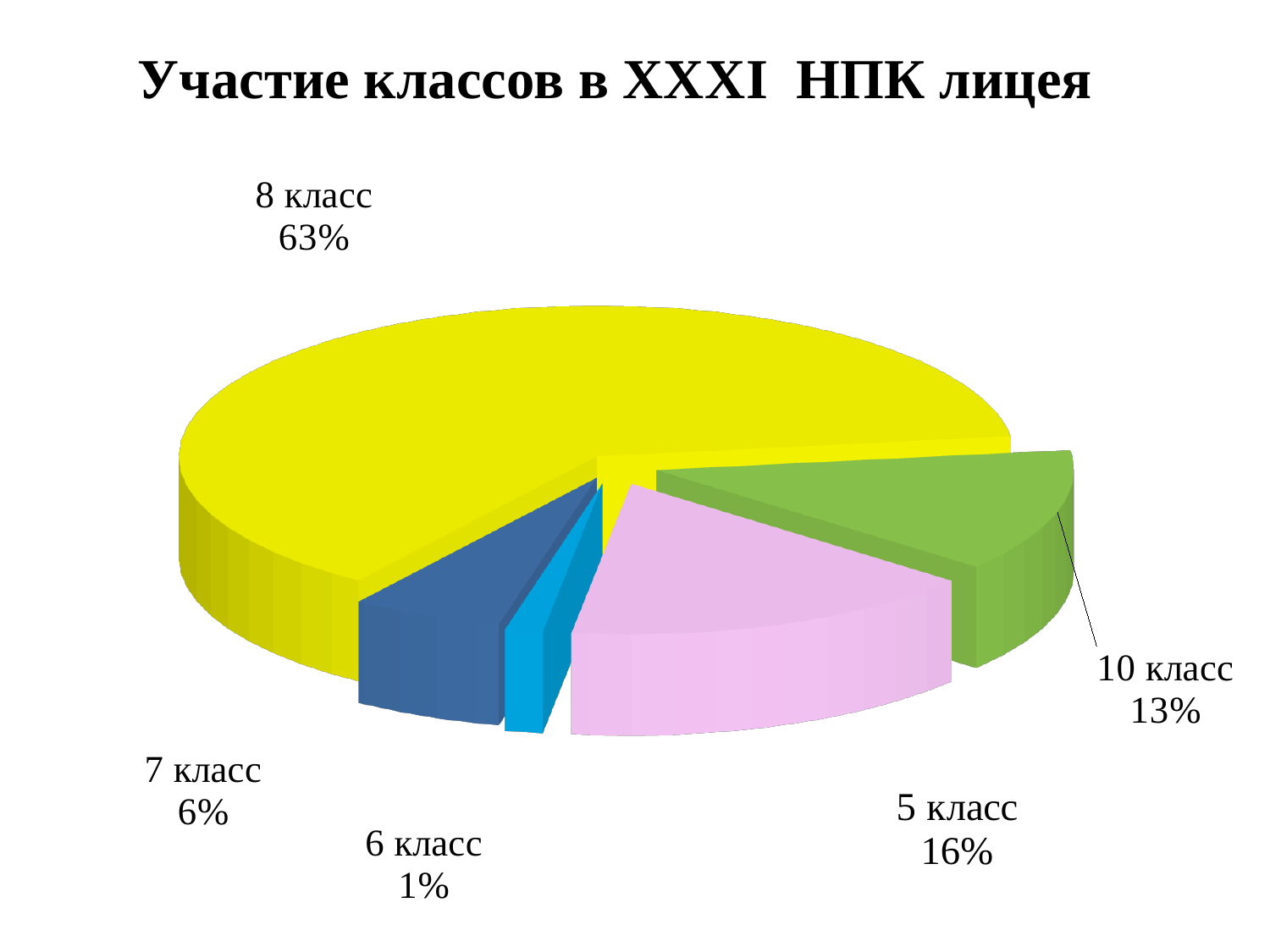
What is the difference between the shares of 5 класс and 10 класс? 3% Which class has the smallest slice of the pie? 6 класс What is the value shown for 6 класс? 1% What kind of chart is shown on the slide? Pie chart What is the value shown for 10 класс? 13% What is the value shown for 5 класс? 16% What share of the pie does 8 класс have? 63% Which has a larger share, 7 класс or 10 класс? 10 класс What is the value shown for 7 класс? 6% How many classes (slices) are shown in the pie chart? 5 Which class has the largest slice of the pie? 8 класс What is the title of the chart? Участие классов в XXXI НПК лицея